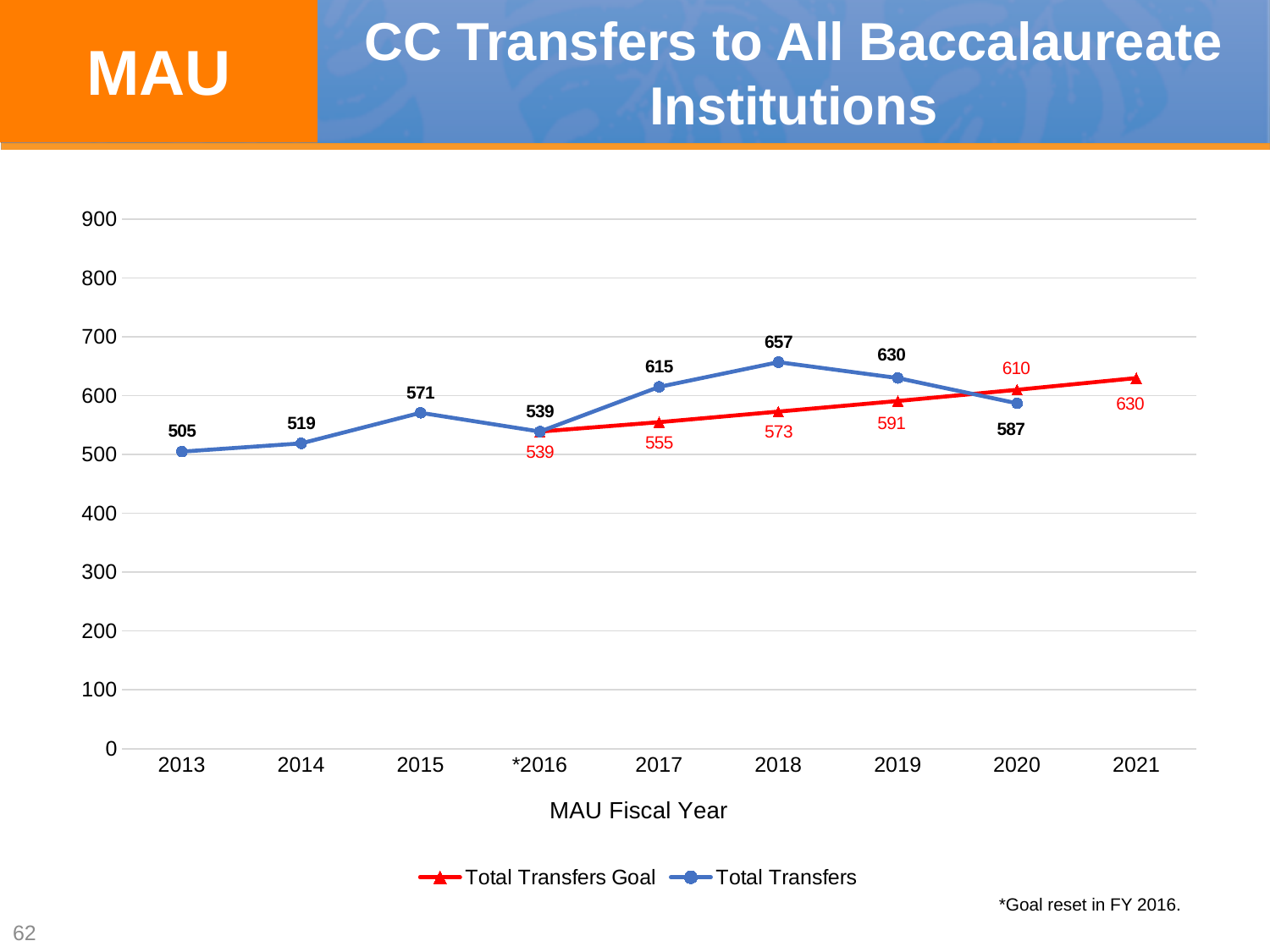
Does the Total Transfers Goal line rise or fall from 2016 to 2021? Rise In which year is Total Transfers lowest? 2013 What kind of chart is shown on the slide? Line chart Is the Total Transfers value for 2015 greater or less than 600? less What is the Total Transfers value for 2013? 505 What is the Total Transfers value for 2018? 657 How many series does the legend list? 2 What is the difference between Total Transfers and Total Transfers Goal in 2018? 84 What is the Total Transfers Goal value for 2021? 630 What is the Total Transfers Goal value for 2019? 591 In which year is Total Transfers highest? 2018 In 2020, which is larger: Total Transfers or Total Transfers Goal? Total Transfers Goal